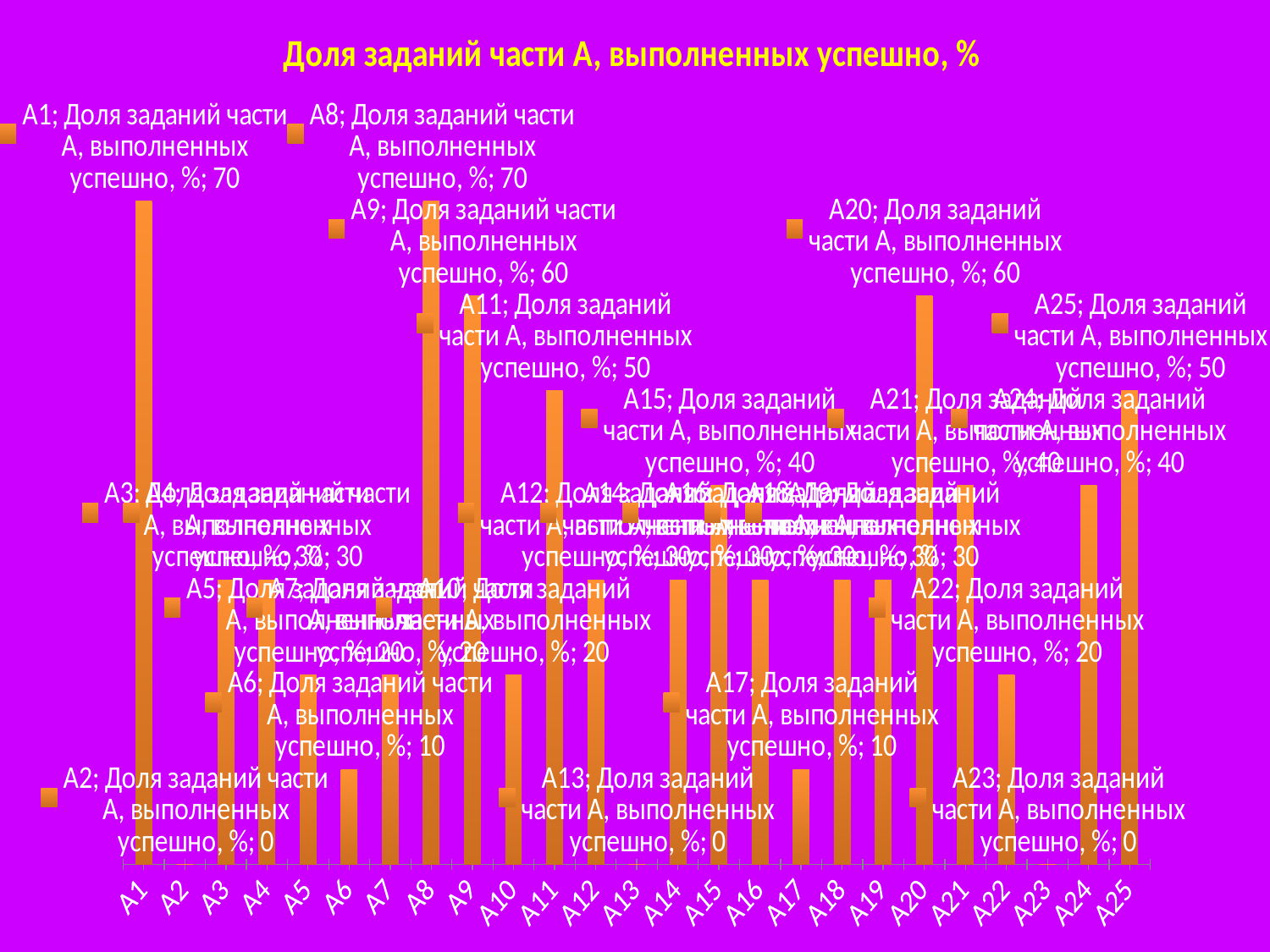
Which is larger, the value for A9 or the value for A11? A9 What is the value for A25? 50 What is the value for A13? 0 What is the value for A20? 60 What is the value for A17? 10 What is the value for A1? 70 How many categories (tasks) are plotted on the x axis? 25 What is the value for A9? 60 What is the difference between the values for A20 and A22? 40 What is the value for A11? 50 What is the title of the chart? Доля заданий части А, выполненных успешно, % What kind of chart is shown on the slide? bar chart